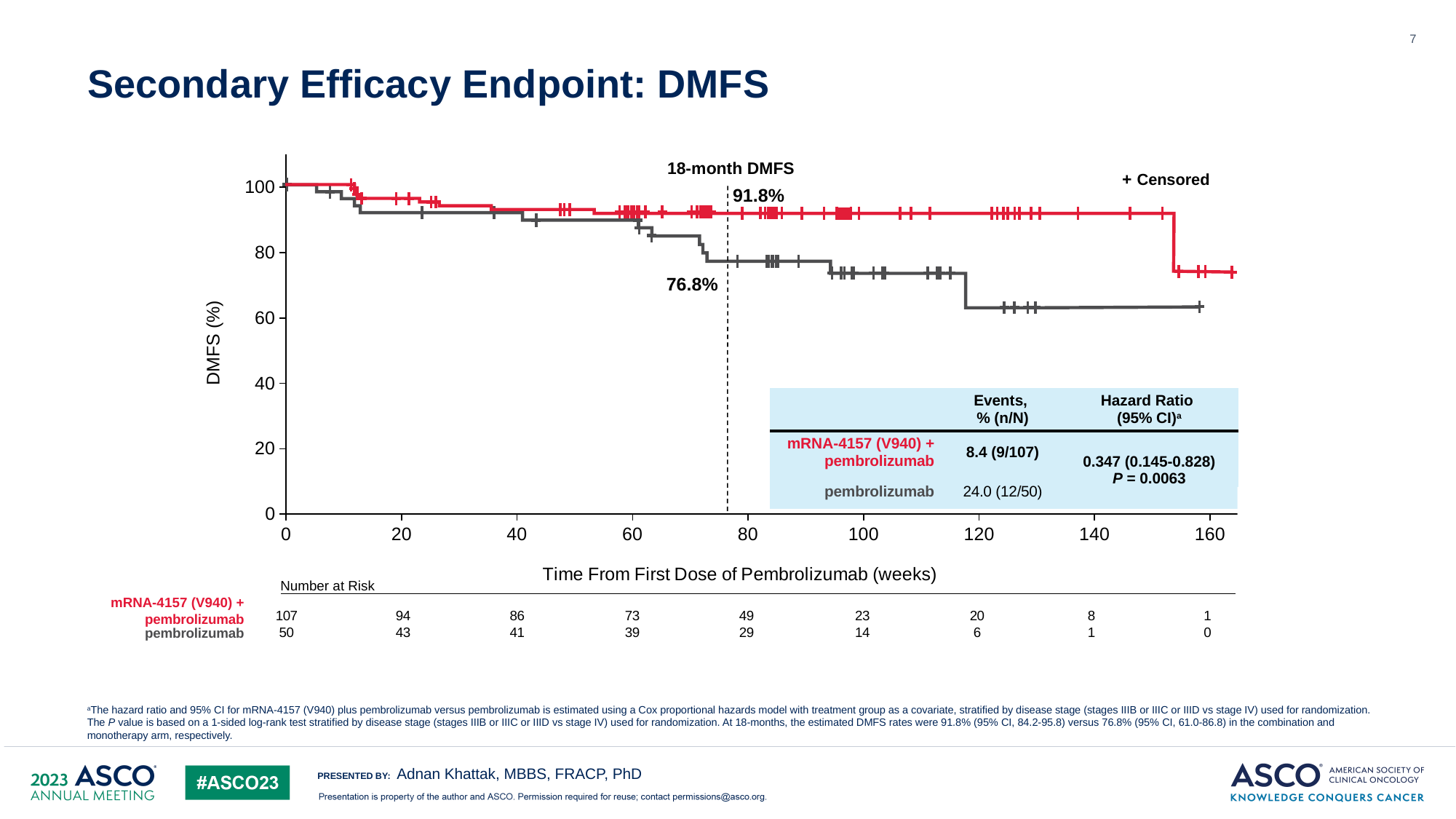
What kind of chart is shown on the slide? Line chart (Kaplan-Meier curve) Which arm has the higher 18-month DMFS rate? mRNA-4157 (V940) + pembrolizumab Do the DMFS curves rise or fall as time from first dose increases? Fall What is the difference in 18-month DMFS between the mRNA-4157 (V940) + pembrolizumab arm and the pembrolizumab arm? 15.0 percentage points How many patients were at risk at week 0 in the mRNA-4157 (V940) + pembrolizumab arm? 107 How many patients were at risk at week 80 in the pembrolizumab arm? 29 What is the 18-month DMFS rate for the mRNA-4157 (V940) + pembrolizumab arm? 91.8% What is the hazard ratio (95% CI) shown in the table? 0.347 (0.145-0.828) What is the label of the y axis? DMFS (%) What is the 18-month DMFS rate for the pembrolizumab arm? 76.8% Is the DMFS value for the pembrolizumab arm at week 140 greater or less than 80%? less What is the event rate, % (n/N), for the pembrolizumab arm? 24.0 (12/50)